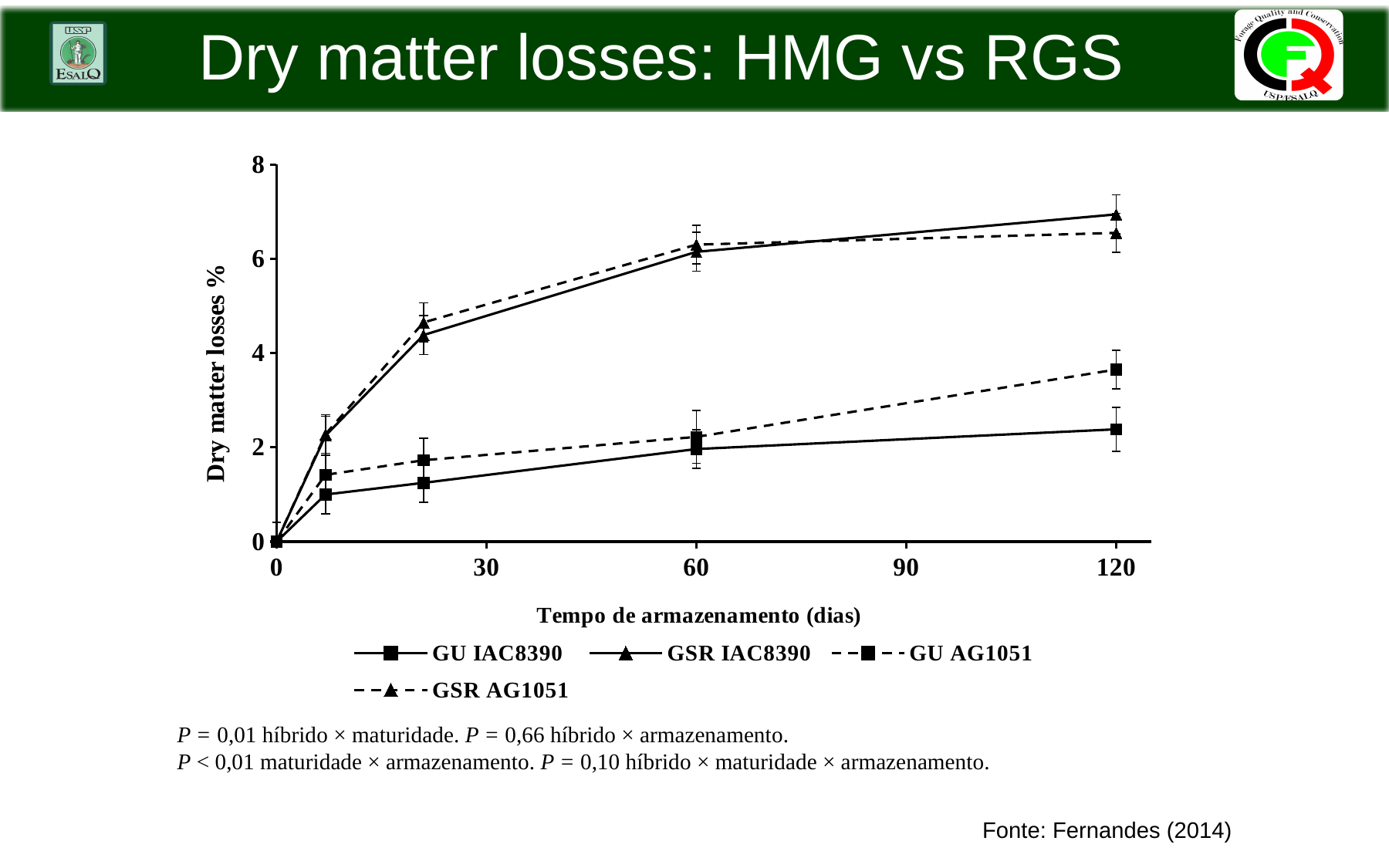
What is the value for GSR IAC8390 at 0 days? 0 How many series does the legend list? 4 Is the value for GU AG1051 at 120 days greater or less than 2? greater What is the title of the x axis? Tempo de armazenamento (dias) Do the values for GSR IAC8390 rise or fall as storage time increases? rise At 120 days, which is larger: GSR AG1051 or GU AG1051? GSR AG1051 What kind of chart is shown on the slide? line chart Is the value for GU IAC8390 at 120 days greater or less than 4? less Is the value for GSR IAC8390 at 120 days greater or less than 6? greater Which series has the lowest value at 120 days? GU IAC8390 What is the title of the y axis? Dry matter losses %